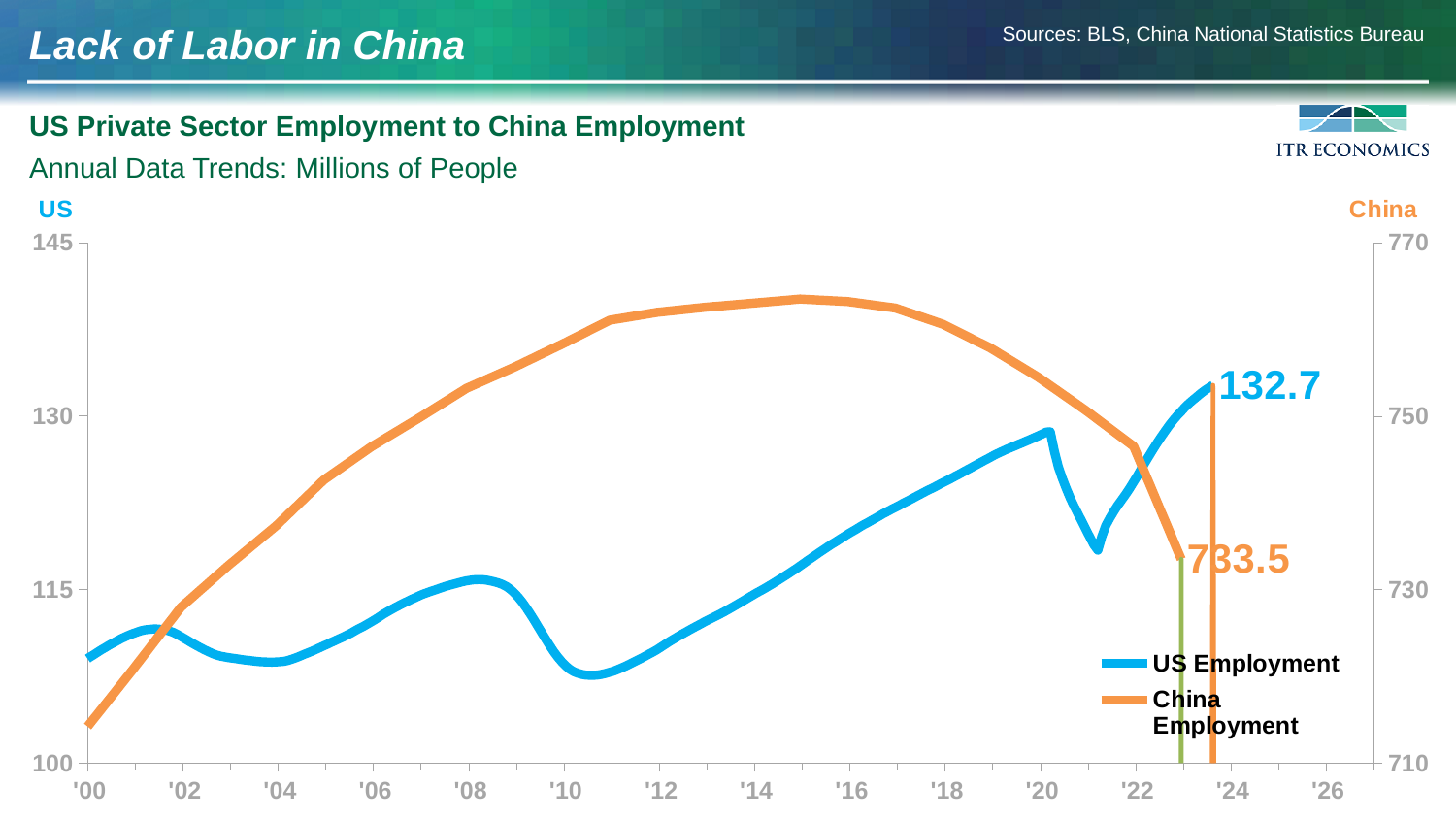
How many year labels are shown on the x axis? 14 Is the China Employment value at '00 greater or less than 730? less Is the US Employment value around '10 greater or less than 115? less What is the title of the chart? US Private Sector Employment to China Employment Is the China Employment value around '15 greater or less than 750? greater What is the latest labeled value for China Employment on the chart? 733.5 Which is larger for US Employment: the value around '08 or the value around '10? '08 Does the China Employment line rise or fall between '15 and '23? Falls What is the latest labeled value for US Employment on the chart? 132.7 Which colour is used for the China Employment line? Orange What kind of chart is shown on the slide? Line chart How many series does the chart's legend list? 2